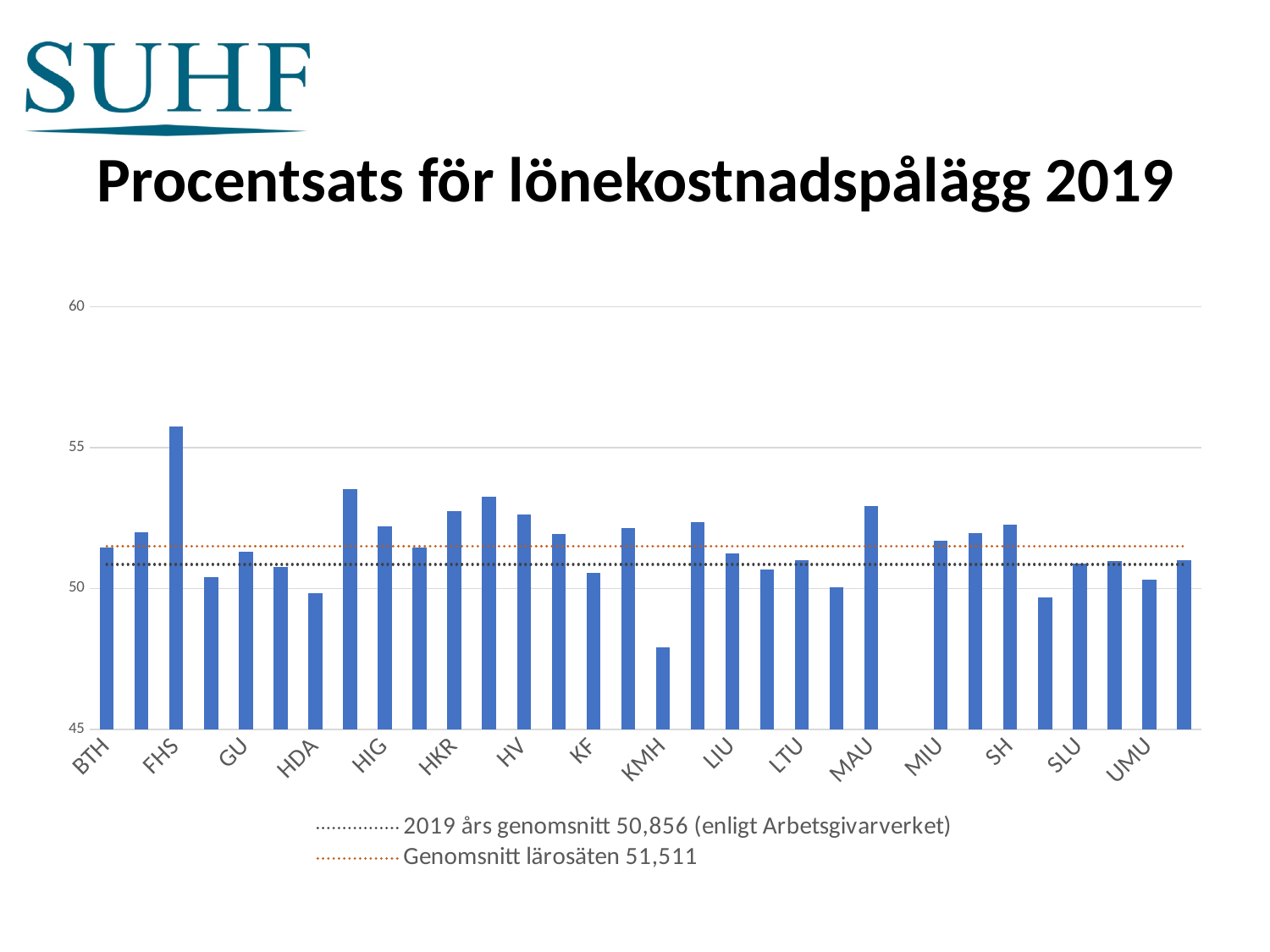
Which has the larger value, MAU or KF? MAU Which institution has the highest bar in the chart? FHS Is the value for FHS greater or less than 55? greater Which has the larger value, HKR or HDA? HKR Is the value for MAU greater or less than 50? greater Which institution has the lowest bar in the chart? KMH What is the title of the chart? Procentsats för lönekostnadspålägg 2019 How many reference lines does the legend list? 2 According to the legend, what is the value of 'Genomsnitt lärosäten'? 51,511 Is the value for KMH greater or less than 50? less What kind of chart is shown on the slide? bar chart According to the legend, what is the 2019 average according to Arbetsgivarverket? 50,856